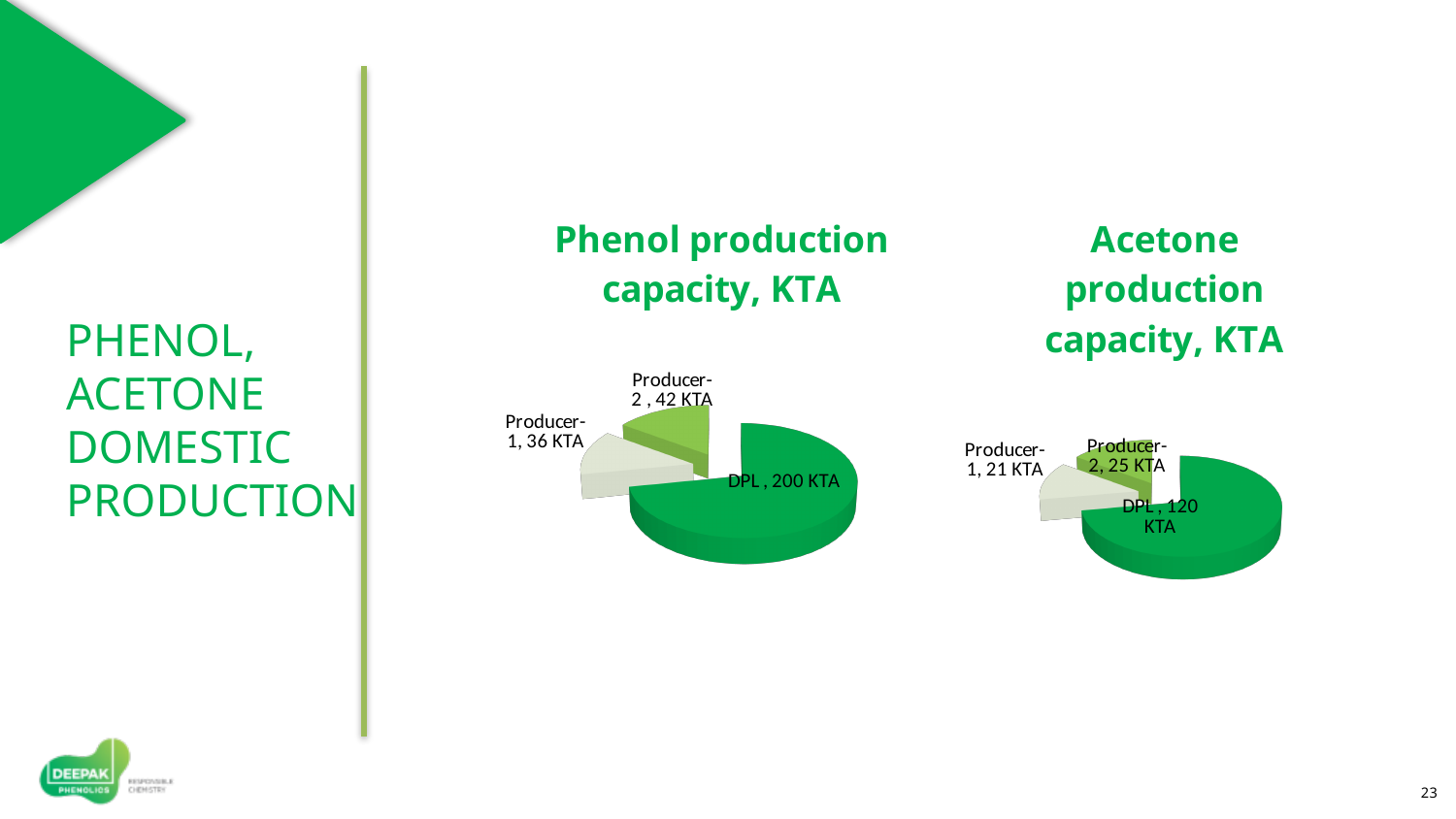
What is the total capacity shown in the Acetone production capacity chart? 166 KTA How many slices does the Phenol production capacity chart have? 3 In the Phenol production capacity chart, which is larger, Producer-1 or Producer-2? Producer-2 In the Acetone production capacity chart, what is the difference between Producer-2 and Producer-1? 4 KTA In the Acetone production capacity chart, which producer has the smallest capacity? Producer-1 What type of chart is the Acetone production capacity chart? Pie chart In the Phenol production capacity chart, which producer has the largest capacity? DPL In the Acetone production capacity chart, what is the value for DPL? 120 KTA In the Acetone production capacity chart, what is the value for Producer-1? 21 KTA In the Phenol production capacity chart, what is the difference between DPL and Producer-2? 158 KTA In the Phenol production capacity chart, what is the value for Producer-2? 42 KTA In the Phenol production capacity chart, what is the value for DPL? 200 KTA